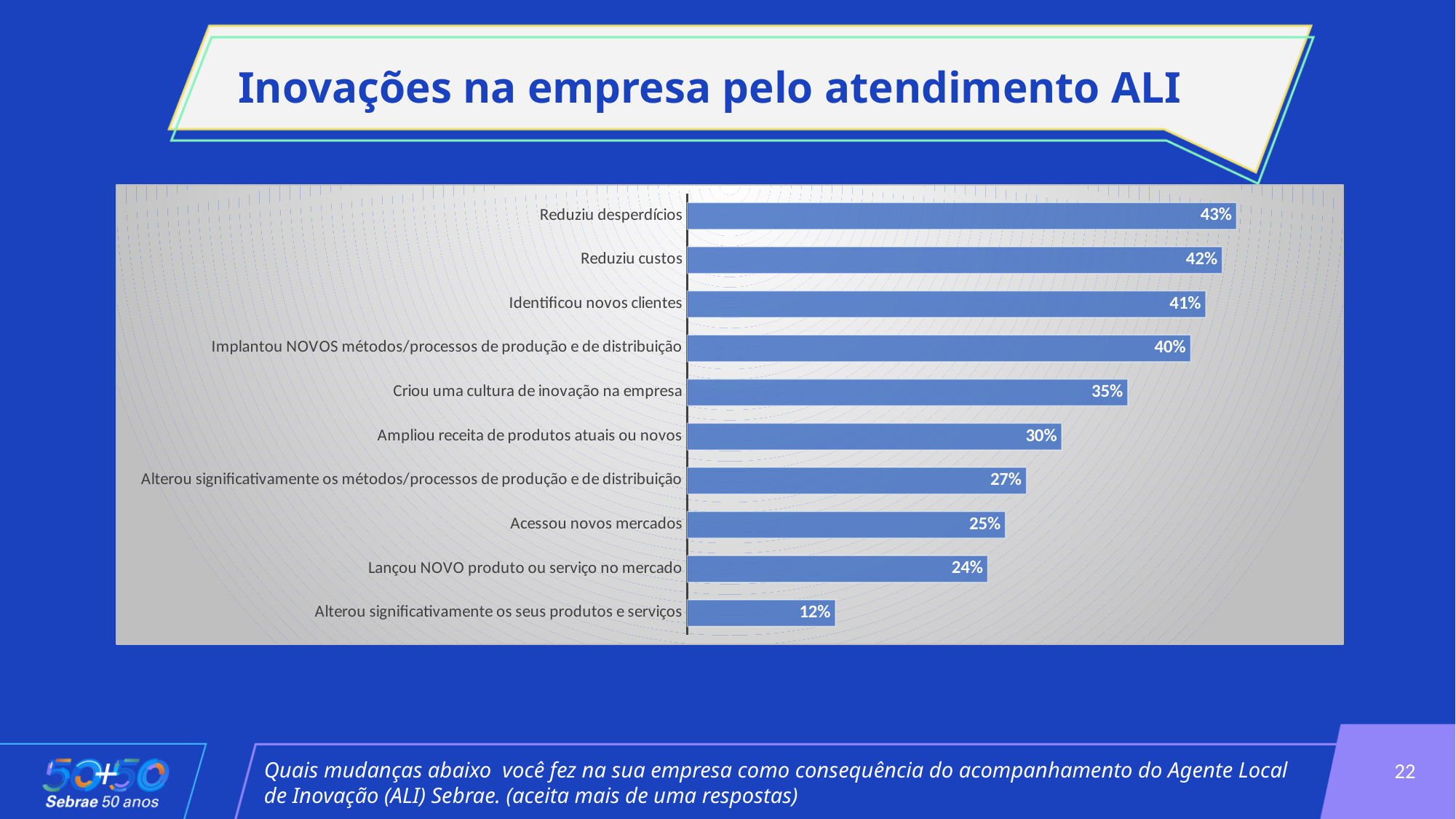
What is the difference between "Ampliou receita de produtos atuais ou novos" and "Acessou novos mercados"? 5% What is the value for "Implantou NOVOS métodos/processos de produção e de distribuição"? 40% What is the title of the slide containing the chart? Inovações na empresa pelo atendimento ALI What kind of chart is shown on the slide? Bar chart Which category has the highest value? Reduziu desperdícios What is the value for "Reduziu desperdícios"? 43% What is the value for "Criou uma cultura de inovação na empresa"? 35% Which is larger: "Identificou novos clientes" or "Acessou novos mercados"? Identificou novos clientes What is the value for "Lançou NOVO produto ou serviço no mercado"? 24% How many categories are shown in the chart? 10 Which category has the lowest value? Alterou significativamente os seus produtos e serviços What is the difference between "Reduziu desperdícios" and "Alterou significativamente os seus produtos e serviços"? 31%